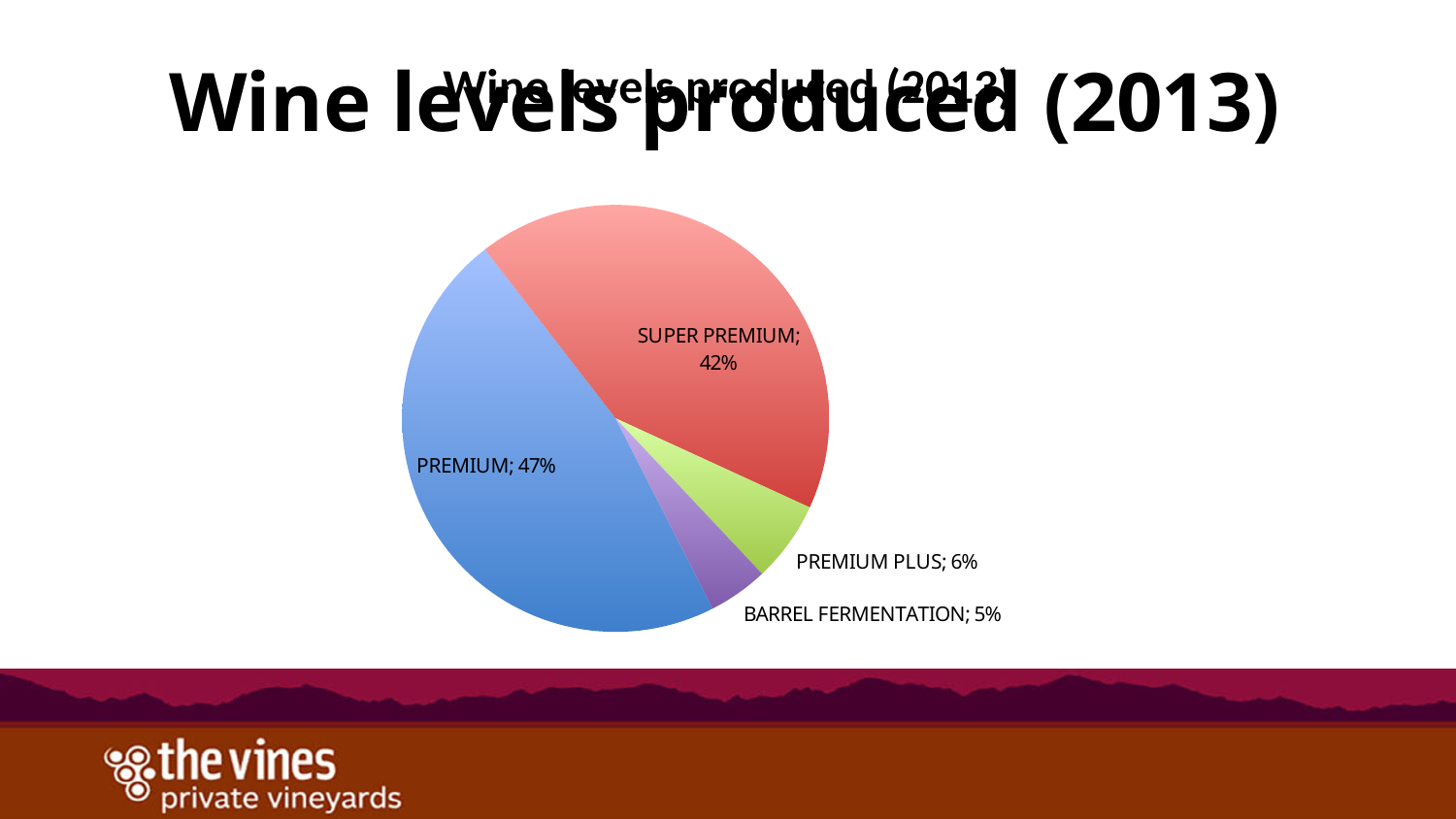
Which is larger, the PREMIUM PLUS slice or the BARREL FERMENTATION slice? PREMIUM PLUS What is the difference in percentage points between PREMIUM and SUPER PREMIUM? 5 Which category has the smallest slice of the pie? BARREL FERMENTATION What is the combined share of PREMIUM PLUS and BARREL FERMENTATION? 11% What share of wine levels produced in 2013 is PREMIUM? 47% Which category has the largest slice of the pie? PREMIUM What colour is the PREMIUM slice of the pie? blue What share of wine levels produced in 2013 is BARREL FERMENTATION? 5% How many categories are shown in the pie chart? 4 What kind of chart is shown on the slide? pie chart What share of wine levels produced in 2013 is PREMIUM PLUS? 6% What share of wine levels produced in 2013 is SUPER PREMIUM? 42%